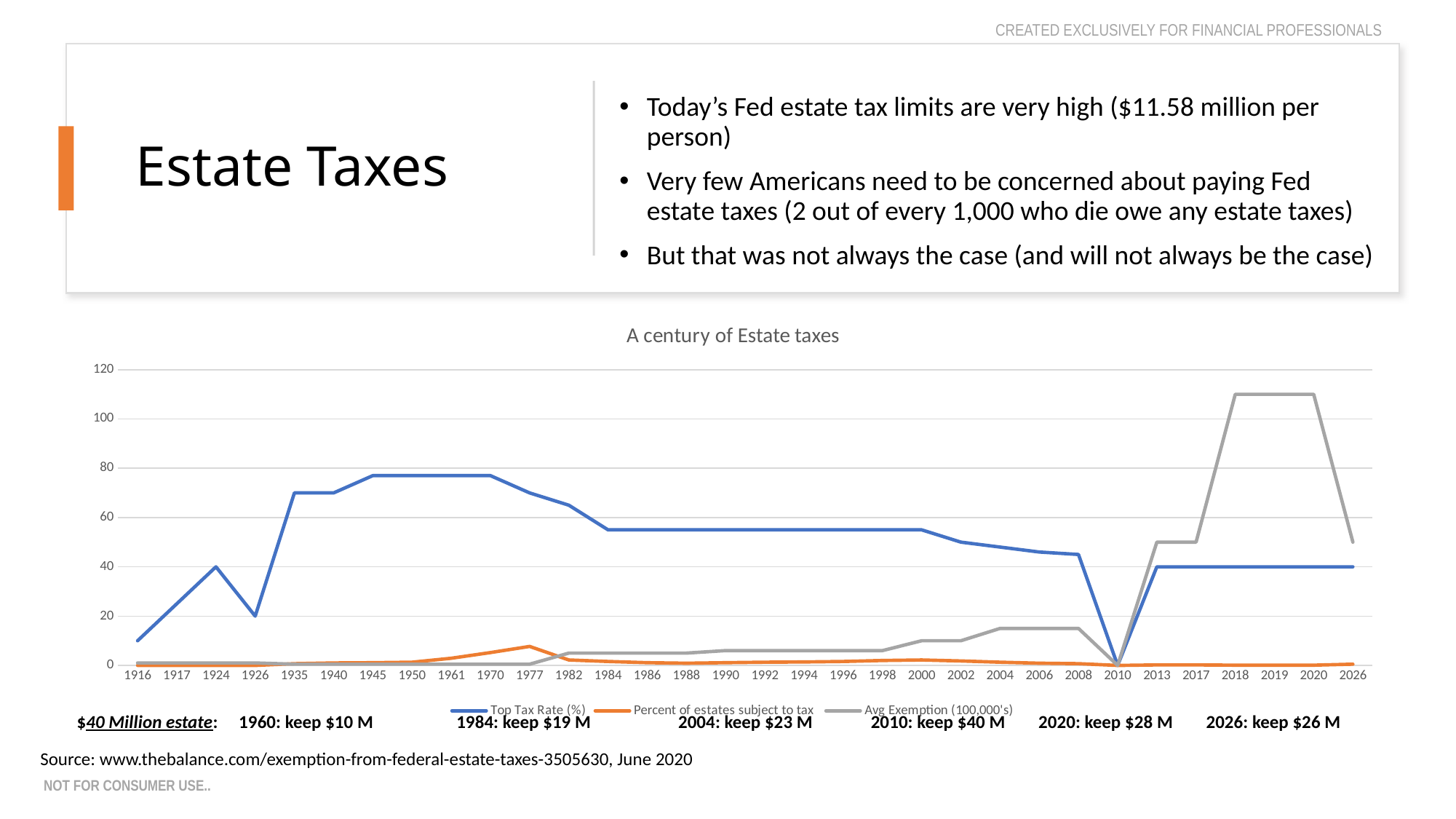
Is the Avg Exemption (100,000's) value for 2018 greater or less than 100? greater Does the Avg Exemption (100,000's) line rise or fall from 2020 to 2026? Fall Which is larger, the Top Tax Rate (%) in 1945 or in 2026? 1945 What kind of chart is shown on the slide? Line chart How many years are shown along the x axis of the chart? 32 What is the Top Tax Rate (%) value for 2010? 0 Which colour is used for the Avg Exemption (100,000's) series? Grey What is the Top Tax Rate (%) value for 2026? 40 How many series does the chart legend list? 3 What is the title of the chart? A century of Estate taxes In which year is the Top Tax Rate (%) lowest? 2010 Is the Top Tax Rate (%) value for 1984 greater or less than 60? less